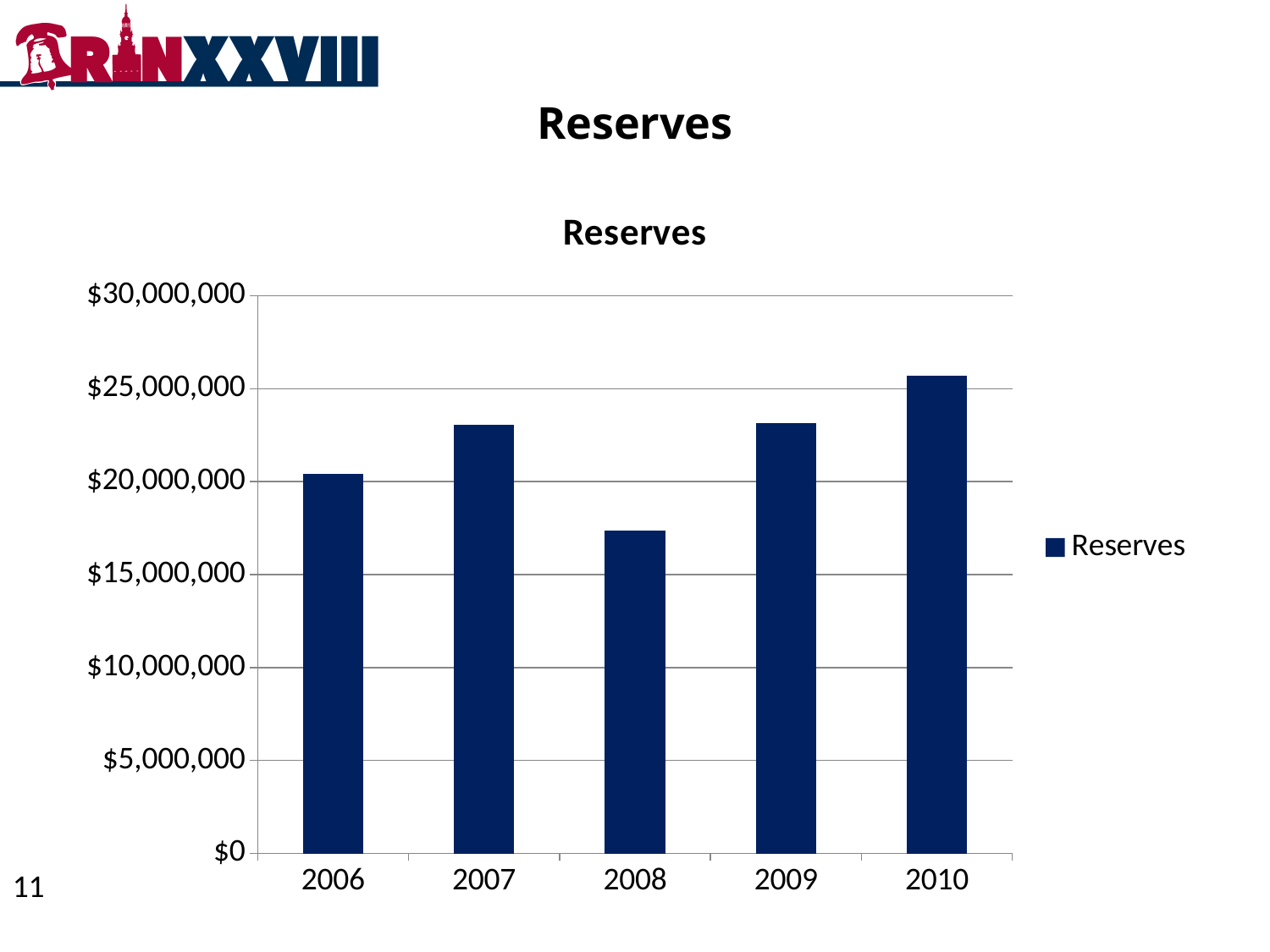
Is the value for 2010 greater or less than $25,000,000? greater Is the value for 2008 greater or less than $20,000,000? less Is the value for 2008 greater or less than $15,000,000? greater How many series does the legend list? 1 What type of chart is shown on the slide? bar chart Which year has the highest reserves? 2010 Which is larger, the reserves for 2006 or for 2008? 2006 How many years are shown on the x axis of the chart? 5 Which year has the lowest reserves? 2008 Which is larger, the reserves for 2010 or for 2007? 2010 What is the title of the chart? Reserves